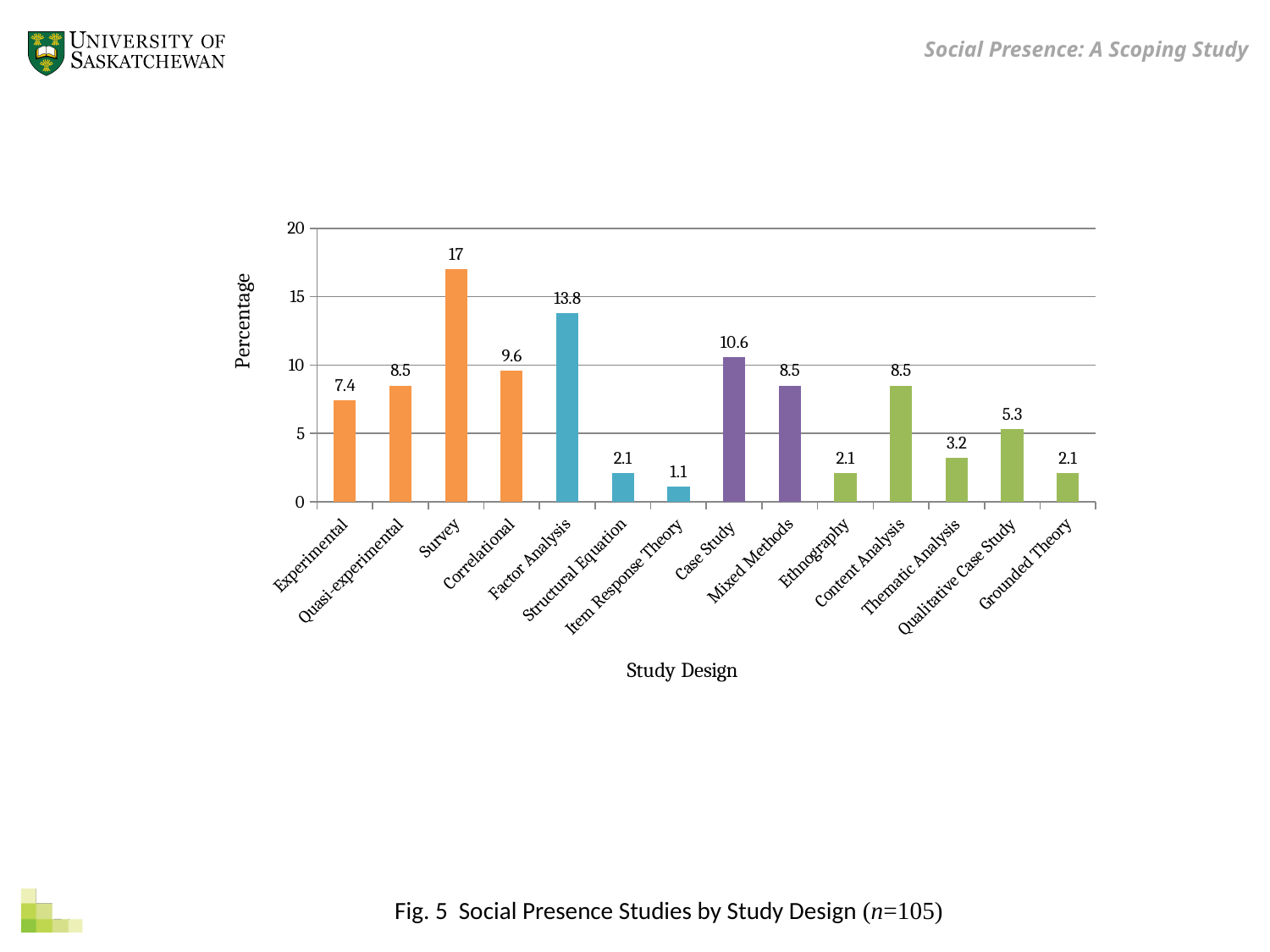
What is the percentage for Factor Analysis? 13.8 What is the figure caption below the chart? Fig. 5 Social Presence Studies by Study Design (n=105) How many study design categories are shown on the x axis? 14 Which study design has the lowest percentage? Item Response Theory Which study design has the highest percentage? Survey Is the value for Mixed Methods greater or less than 10? less What kind of chart is shown on the slide? bar chart What is the percentage for Item Response Theory? 1.1 What is the difference in percentage between Survey and Case Study? 6.4 What is the percentage for Survey? 17 Which has a higher percentage, Correlational or Qualitative Case Study? Correlational What is the label of the y axis? Percentage